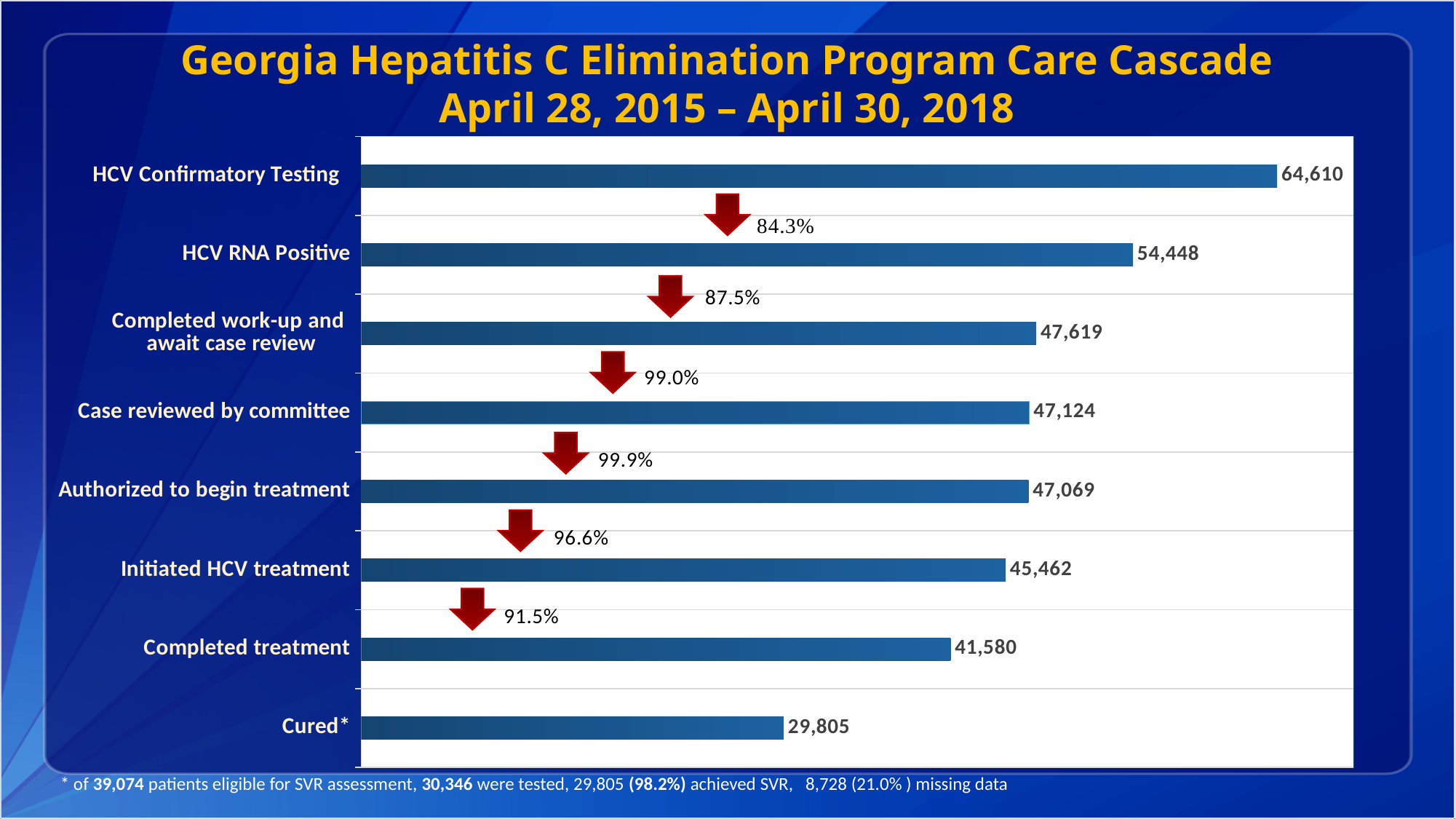
What is the value for Cured*? 29,805 What percentage is shown on the arrow between HCV RNA Positive and Completed work-up and await case review? 87.5% What is the difference between HCV Confirmatory Testing and HCV RNA Positive? 10,162 What is the difference between Initiated HCV treatment and Completed treatment? 3,882 Do the values rise or fall going down the chart from HCV Confirmatory Testing to Cured*? Fall What is the value for HCV Confirmatory Testing? 64,610 Which category has the highest value? HCV Confirmatory Testing How many categories are shown in the chart? 8 Which category has the lowest value? Cured* What kind of chart is shown on the slide? Bar chart What is the value for Completed treatment? 41,580 Which is larger, Case reviewed by committee or Authorized to begin treatment? Case reviewed by committee